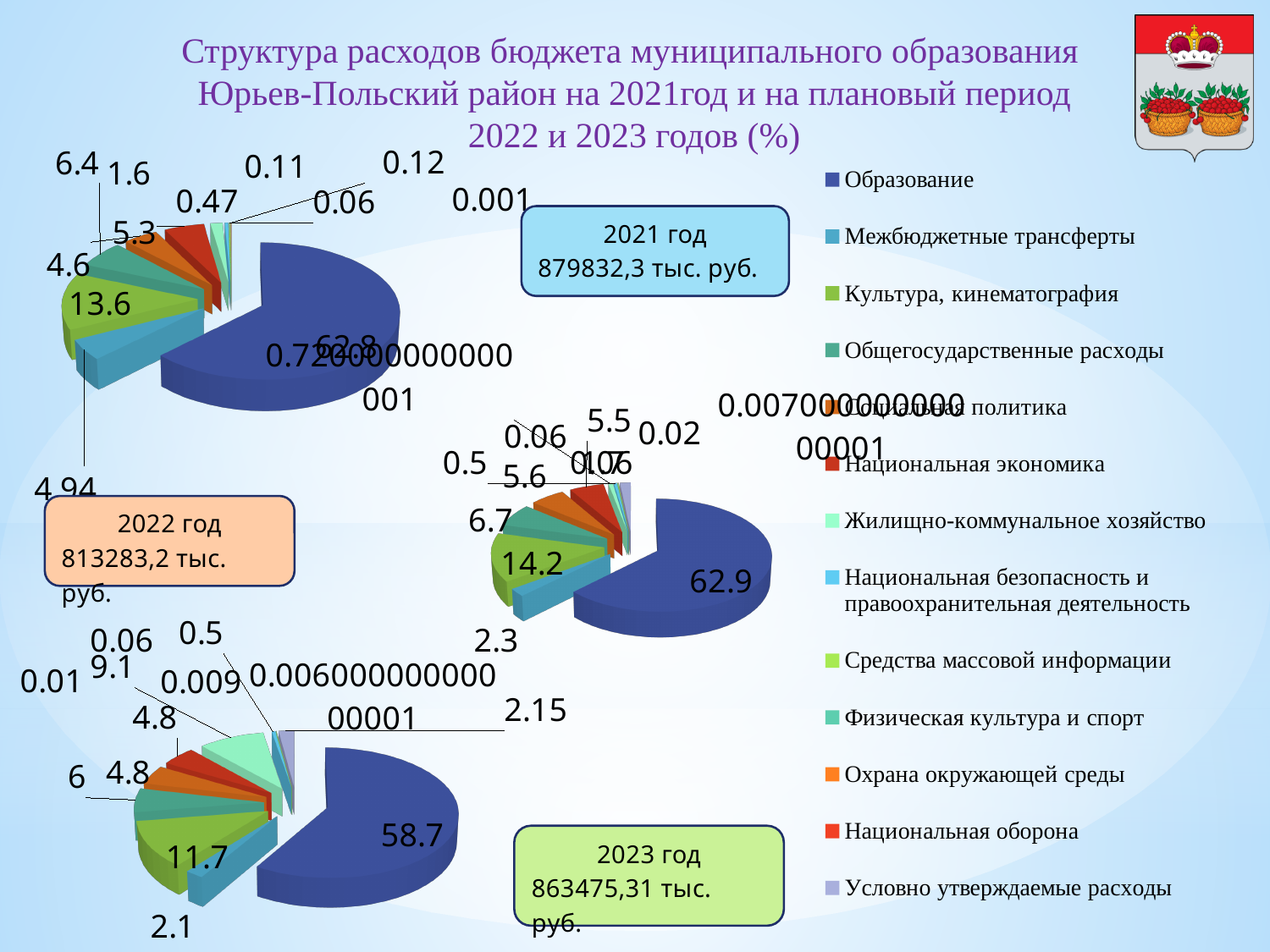
In the 2022 год pie chart, what is the value of the largest slice? 62.9 Which is larger: the largest slice in the 2022 год chart or the largest slice in the 2023 год chart? 2022 год In the 2023 год pie chart, what is the value of the second-largest slice? 11.7 How many pie charts are shown on the slide? 3 What total budget expenditure is shown in the box for 2021 год? 879832,3 тыс. руб. How many expenditure categories does the legend list? 13 What total budget expenditure is shown in the box for 2023 год? 863475,31 тыс. руб. In the 2023 год pie chart, which category has the largest share? Образование In the 2022 год pie chart, what is the value of the second-largest slice? 14.2 In the 2023 год pie chart, what is the value of the largest slice? 58.7 What is the difference between the largest slice in the 2022 год chart (62.9) and the largest slice in the 2023 год chart (58.7)? 4.2 What kind of chart is used on this slide to show the budget expenditure structure? pie chart